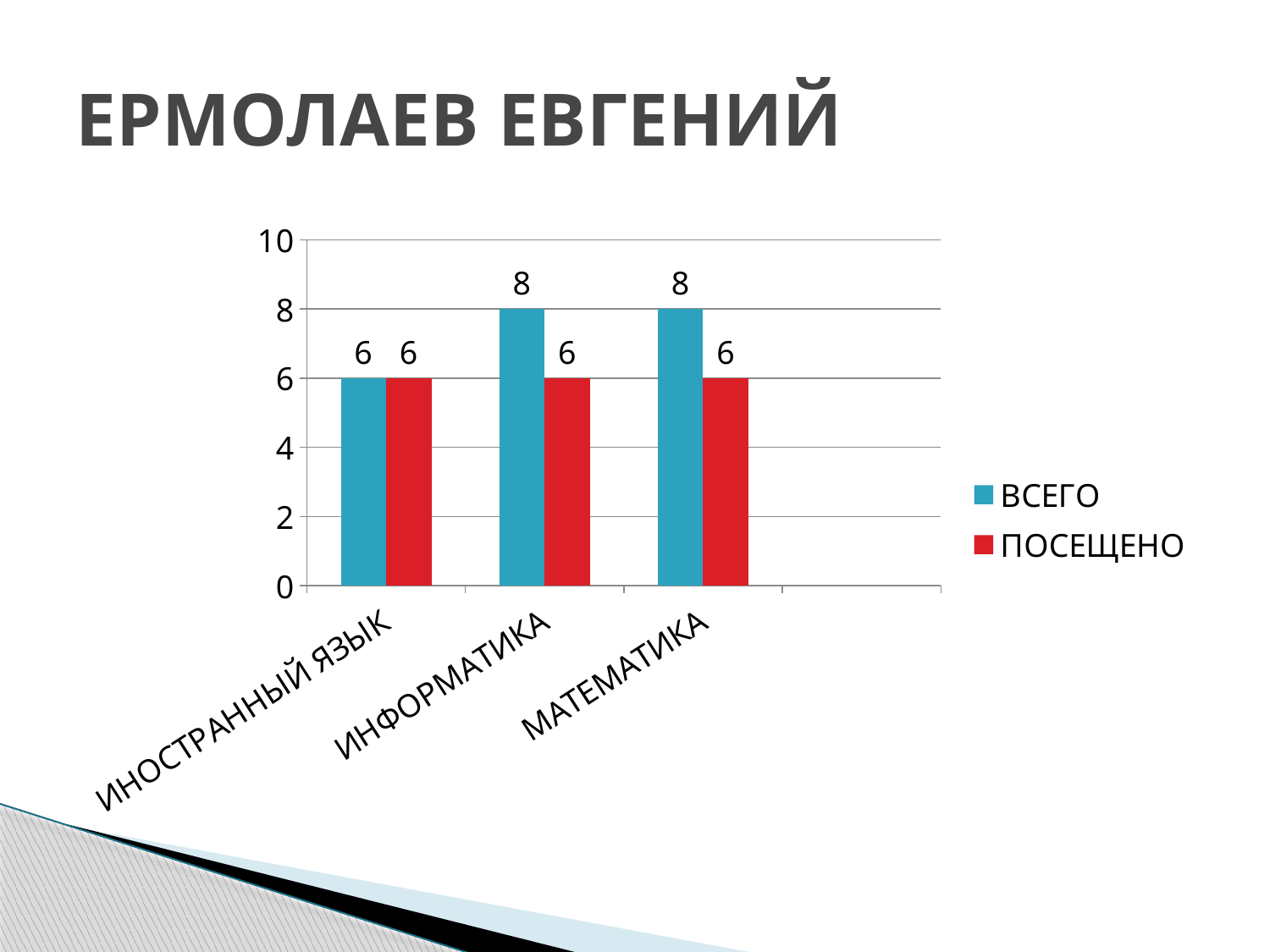
What is the difference between ВСЕГО and ПОСЕЩЕНО for ИНОСТРАННЫЙ ЯЗЫК? 0 What kind of chart is shown on the slide? bar chart What is the ВСЕГО value for ИНФОРМАТИКА? 8 What is the ПОСЕЩЕНО value for МАТЕМАТИКА? 6 Which colour represents the ПОСЕЩЕНО series? red How many categories are shown on the x axis? 3 What is the ВСЕГО value for ИНОСТРАННЫЙ ЯЗЫК? 6 What is the difference between ВСЕГО and ПОСЕЩЕНО for МАТЕМАТИКА? 2 What is the ПОСЕЩЕНО value for ИНФОРМАТИКА? 6 How many series does the legend list? 2 Which category has the lowest ВСЕГО value? ИНОСТРАННЫЙ ЯЗЫК Which is larger for ИНФОРМАТИКА, ВСЕГО or ПОСЕЩЕНО? ВСЕГО